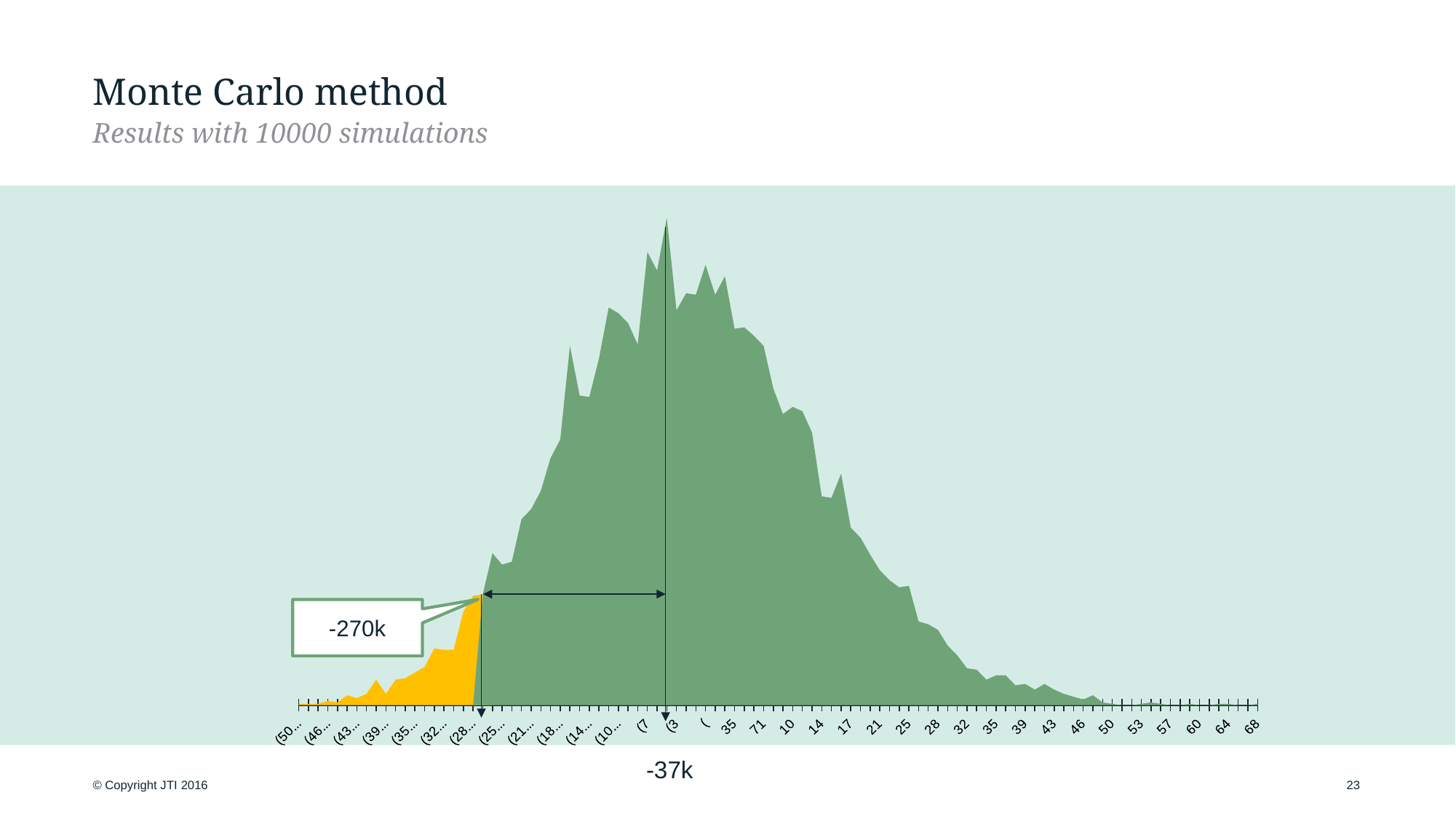
Moving from the peak of the distribution toward the right end of the x axis, do the values rise or fall? fall What value does the callout box pointing to the boundary between the yellow and green areas show? -270k What kind of chart is shown on the slide? area chart Which of the two shaded regions covers the larger area, the yellow one or the green one? green What value is labelled below the vertical line drawn through the peak of the distribution? -37k Moving from the left end of the x axis toward the peak, do the values rise or fall? rise How many simulations does the subtitle say the results are based on? 10000 What is the title of the slide containing the chart? Monte Carlo method